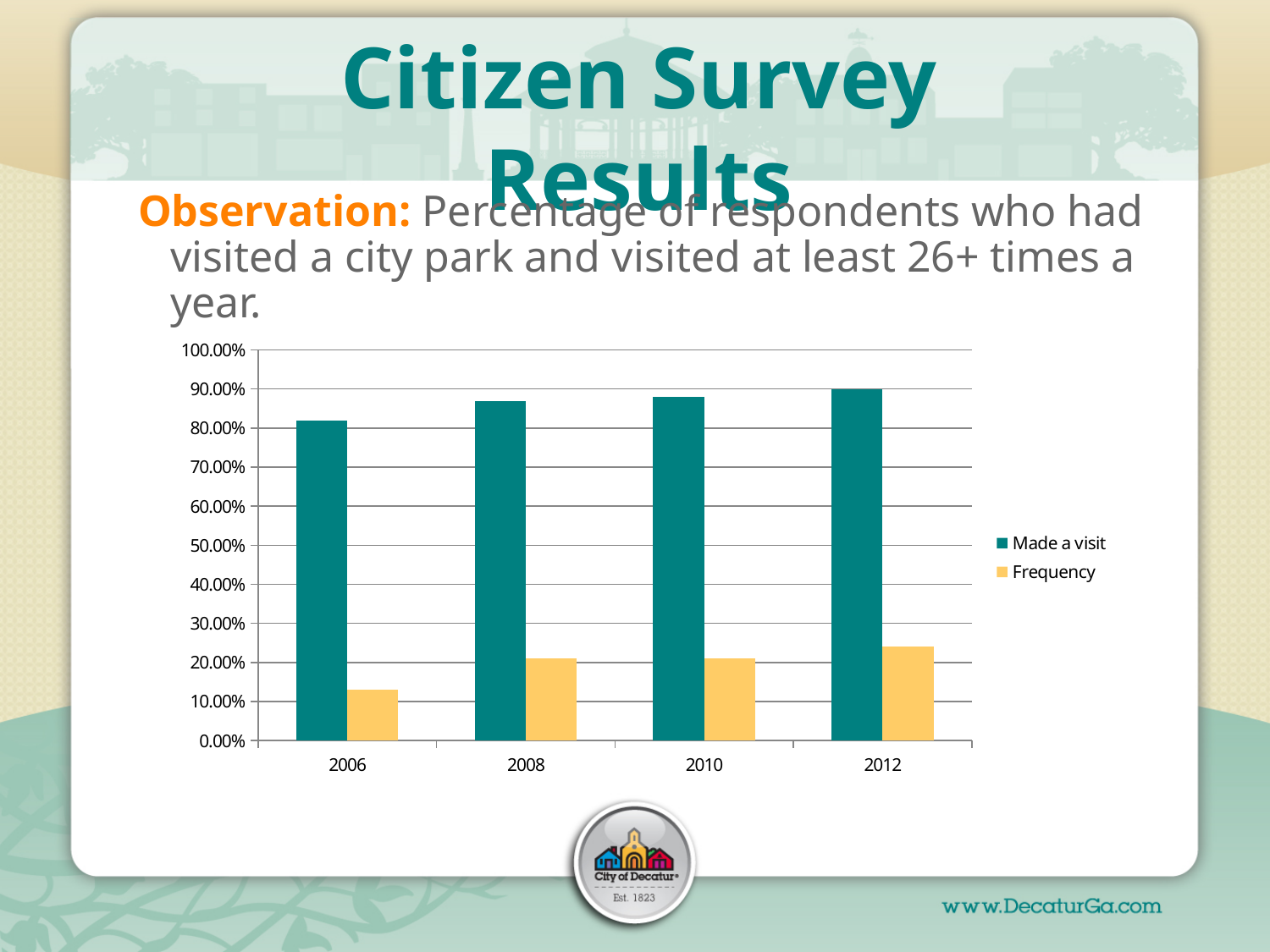
Do the values for Made a visit rise or fall from 2006 to 2012? rise Is the value for Frequency in 2006 greater or less than 20.00%? less Is the value for Made a visit in 2012 greater or less than 80.00%? greater How many years are shown on the x axis? 4 What kind of chart is shown on the slide? bar chart Is the value for Frequency in 2012 greater or less than 30.00%? less Which year has the highest value for Made a visit? 2012 Which series is shown in yellow in the legend? Frequency Which year has the highest value for Frequency? 2012 Which year has the lowest value for Frequency? 2006 How many series does the legend list? 2 Which year has the lowest value for Made a visit? 2006